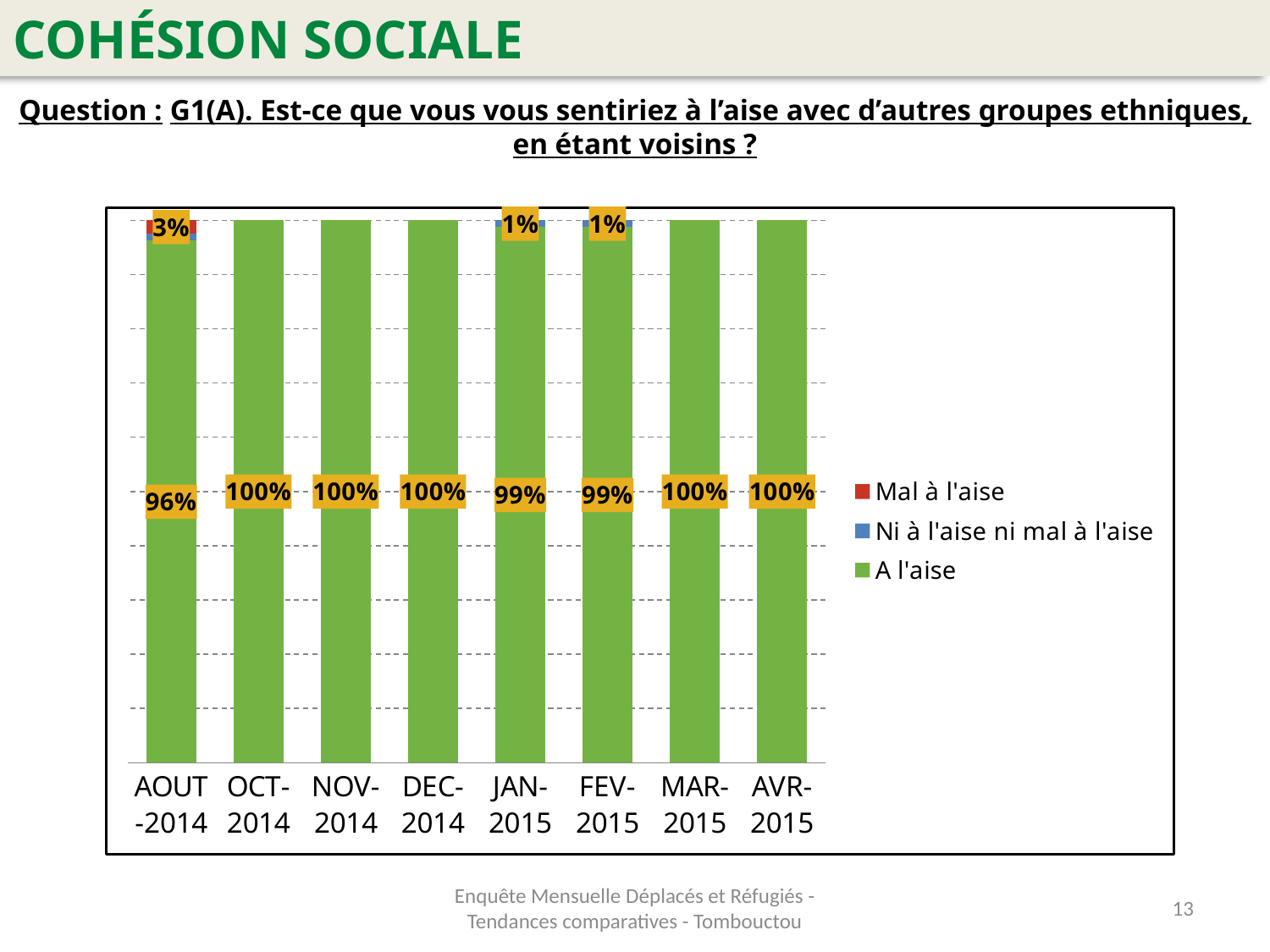
What is the value of 'A l'aise' for OCT-2014? 100% How many months (categories) are shown on the x axis of the chart? 8 What is the value of 'A l'aise' for AOUT-2014? 96% Which is larger, the 'A l'aise' value for AOUT-2014 or for JAN-2015? JAN-2015 Which series is shown in green in the chart legend? A l'aise What type of chart is shown on the slide? Stacked bar chart Which month has the lowest value for 'A l'aise'? AOUT-2014 What is the value of 'A l'aise' for JAN-2015? 99% How many series does the chart legend list? 3 What is the value of 'A l'aise' for FEV-2015? 99% What is the value of 'A l'aise' for AVR-2015? 100% What is the difference between the 'A l'aise' value for OCT-2014 and for AOUT-2014? 4%